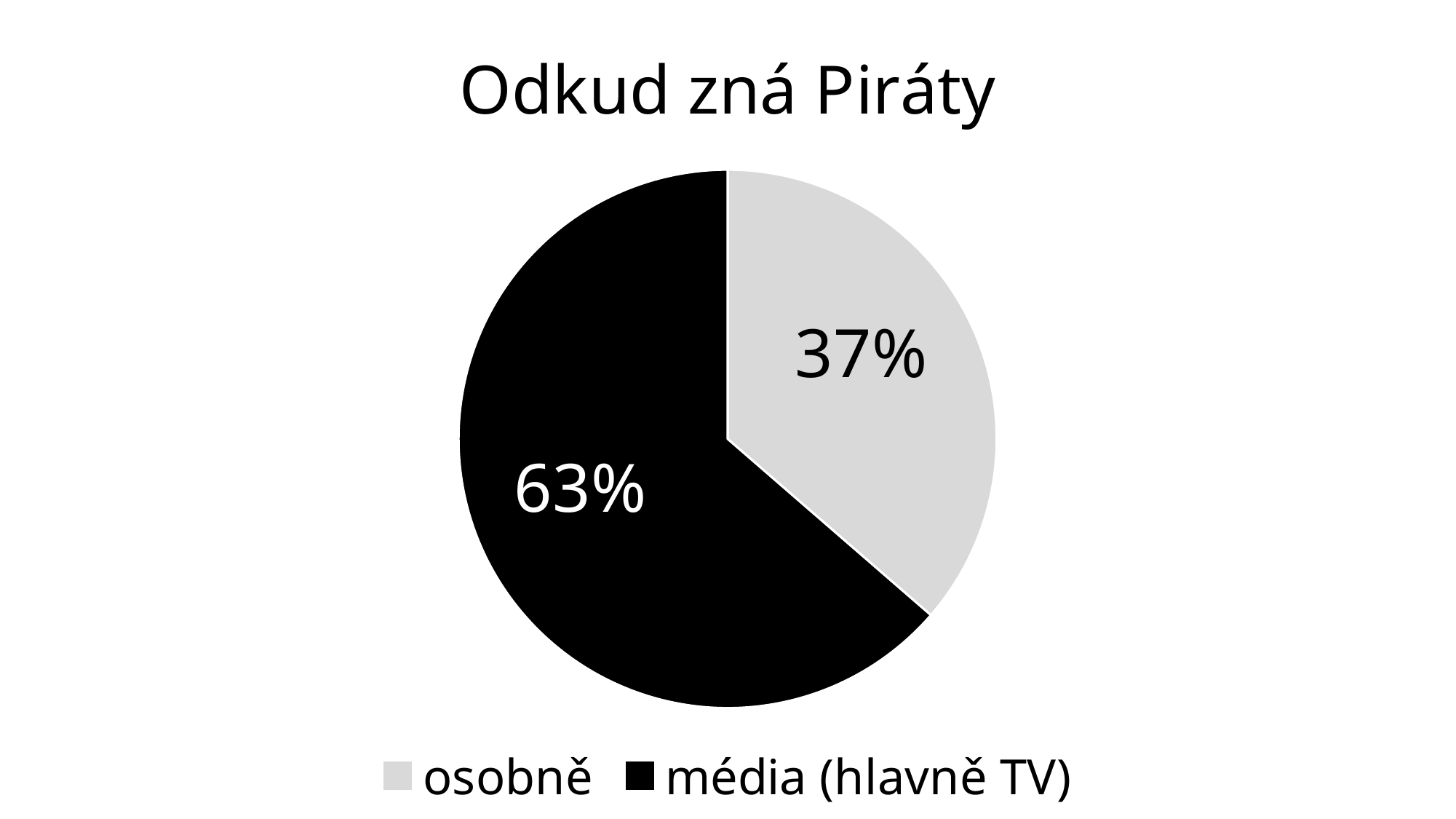
What is the difference in percentage points between "média (hlavně TV)" and "osobně"? 26 Which category has the smallest slice? osobně Which category has the largest slice? média (hlavně TV) How many slices does the pie chart have? 2 What share of the pie does "média (hlavně TV)" take? 63% What share of the pie does "osobně" take? 37% Which colour represents "osobně" in the chart? light grey How many entries does the legend list? 2 What kind of chart is shown on the slide? pie chart Which is larger, the slice for "osobně" or the slice for "média (hlavně TV)"? média (hlavně TV) What is the title of the chart? Odkud zná Piráty Is the share for "osobně" greater or less than 50%? less